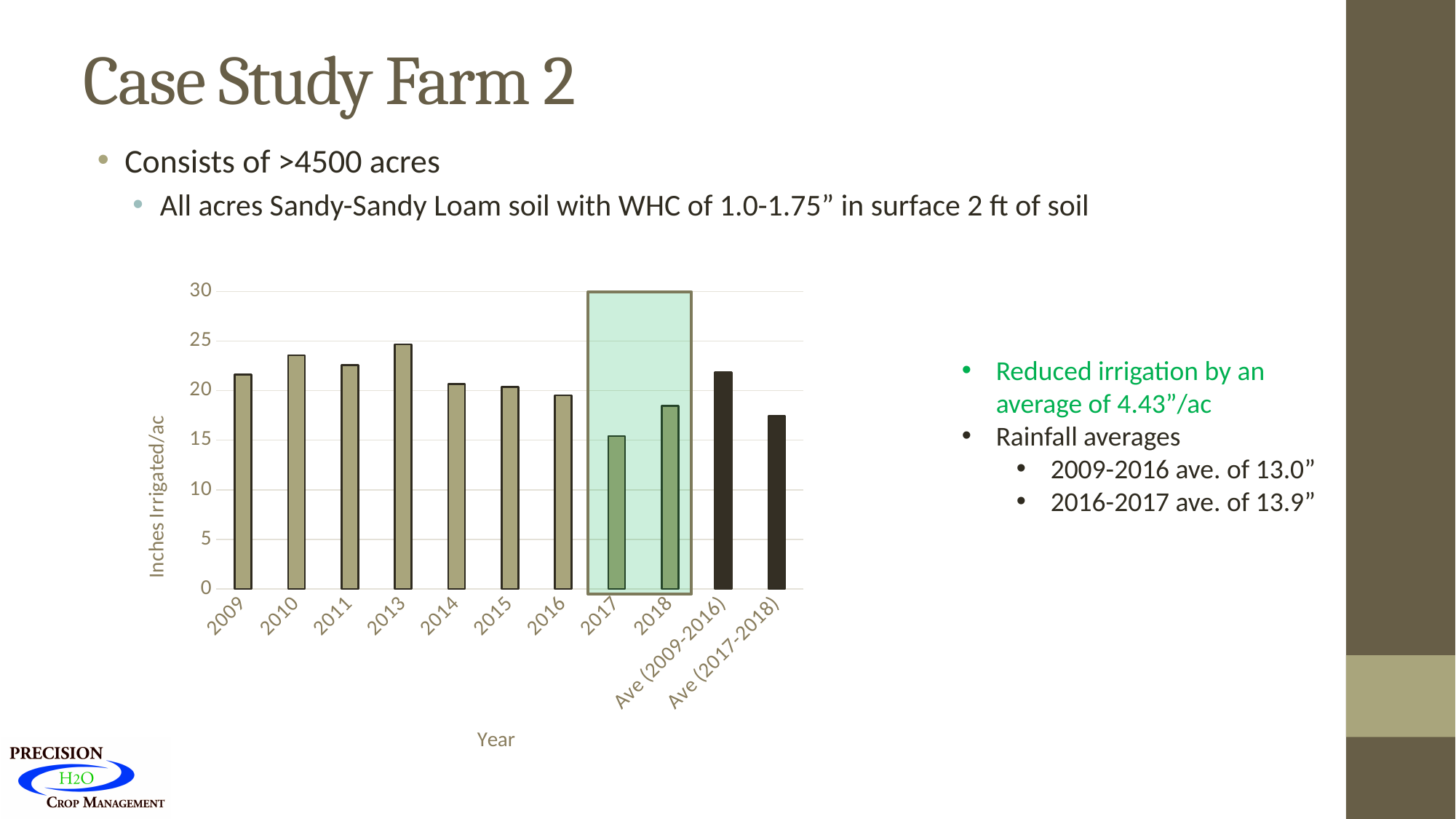
How many bars (categories) are plotted on the chart? 11 Which category has the highest value on the chart? 2013 Which category has the lowest value on the chart? 2017 What kind of chart is shown on the slide? bar chart Is the value for Ave (2009-2016) greater or less than 20? greater Is the value for 2013 greater or less than 20? greater Which is larger, the value for 2010 or the value for 2017? 2010 Is the value for 2017 greater or less than 20? less Which is larger, the value for Ave (2009-2016) or the value for Ave (2017-2018)? Ave (2009-2016) Do the values rise or fall from 2013 to 2017? fall What is the title of the vertical axis of the chart? Inches Irrigated/ac